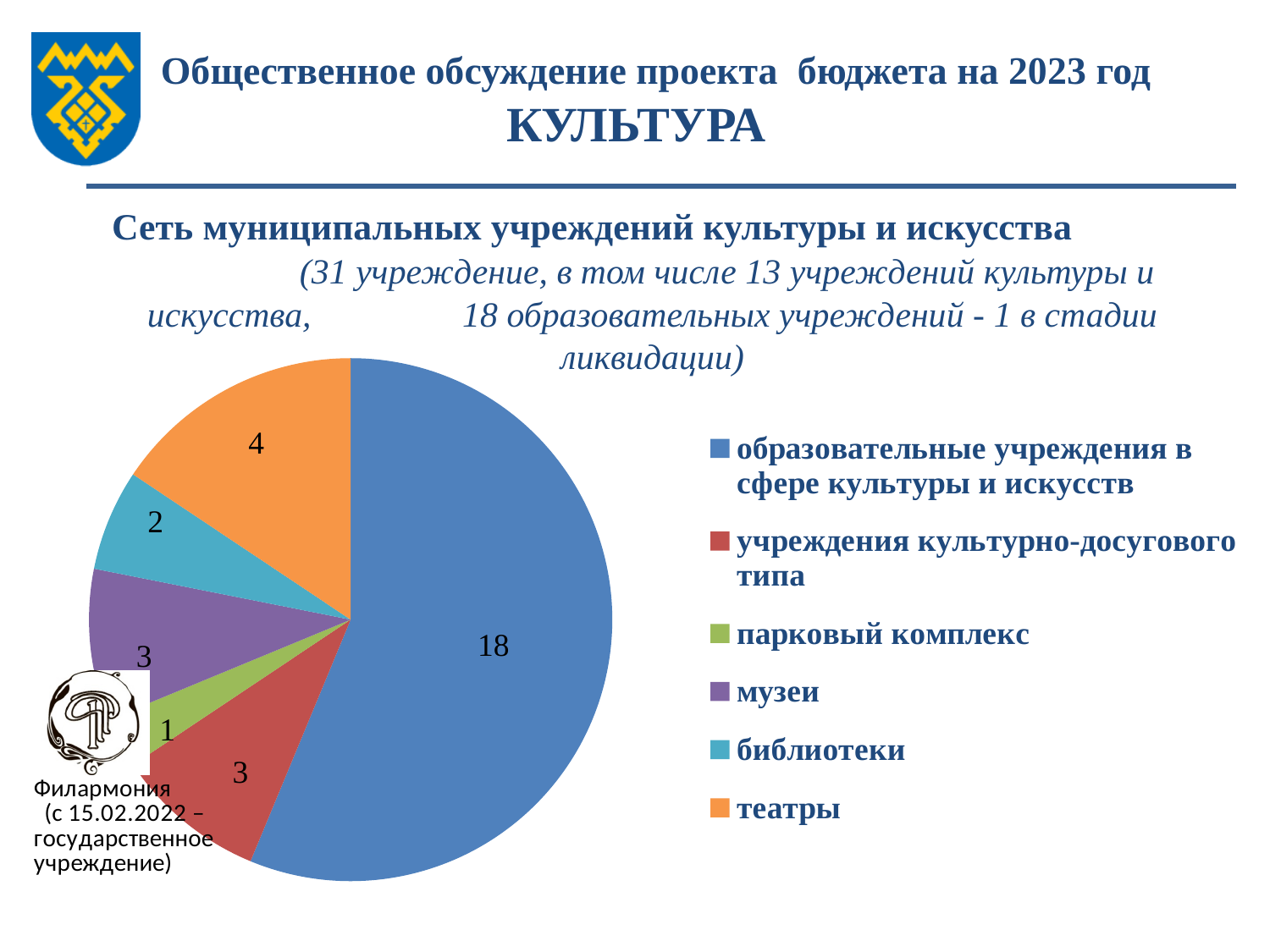
Which category has the largest slice of the pie? образовательные учреждения в сфере культуры и искусств What is the difference between the value for образовательные учреждения в сфере культуры и искусств and the value for театры? 14 How many entries does the legend of the pie chart list? 6 What is the value for театры? 4 Which category has the smallest slice of the pie? парковый комплекс Which is larger: the value for театры or the value for библиотеки? театры What type of chart is shown on the slide? pie chart What is the value for библиотеки? 2 How many slices does the pie chart have? 6 What is the value for парковый комплекс? 1 What is the value for музеи? 3 What is the value for образовательные учреждения в сфере культуры и искусств? 18